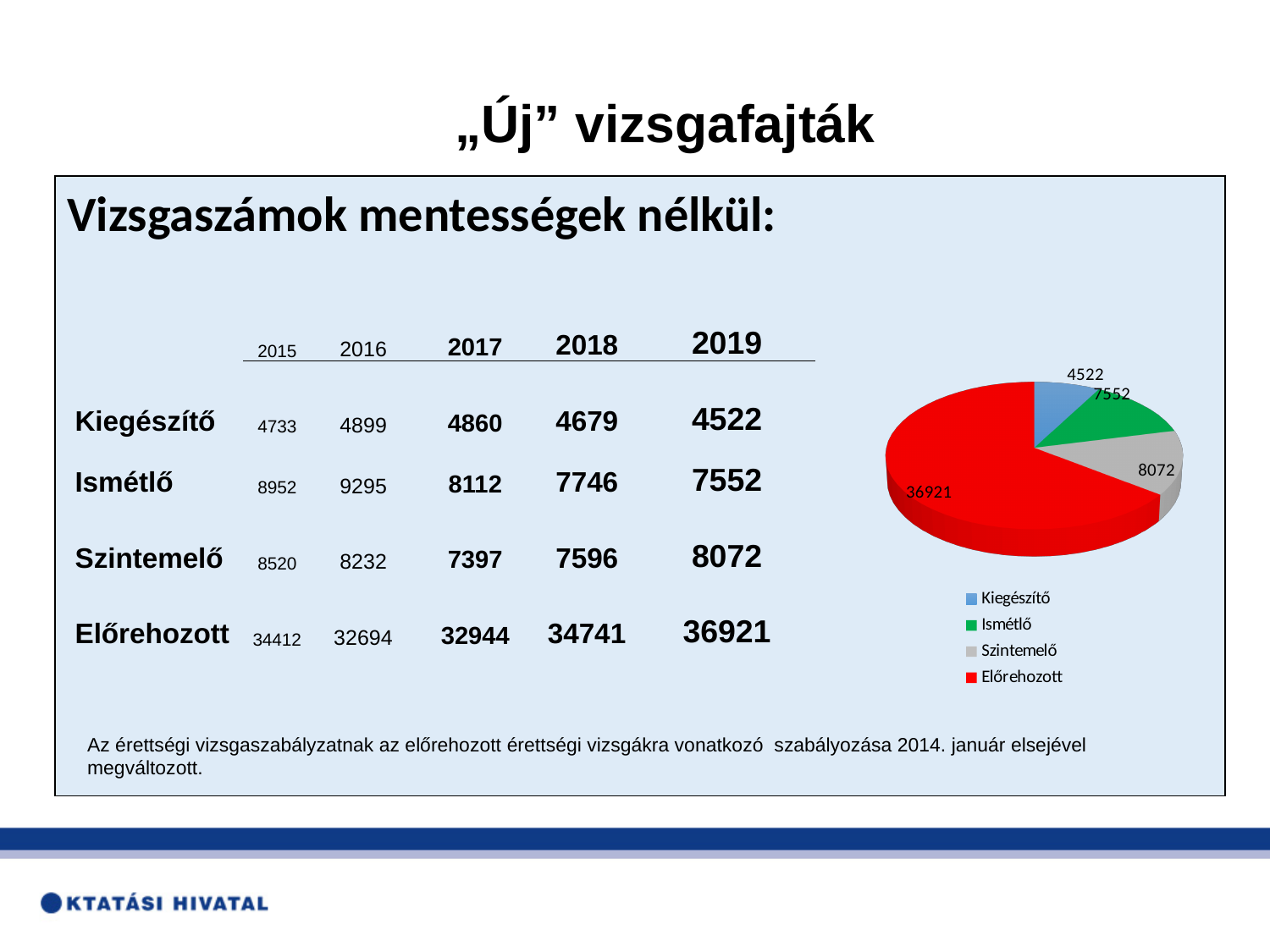
What is the total of all the values shown in the pie chart? 57067 How many entries does the pie chart legend list? 4 What is the value for Kiegészítő in the pie chart? 4522 What is the difference between the values for Szintemelő and Ismétlő in the pie chart? 520 How many slices does the pie chart have? 4 Which category has the largest slice in the pie chart? Előrehozott What colour is the Előrehozott slice in the pie chart? red What is the value for Szintemelő in the pie chart? 8072 What kind of chart is shown on the slide? pie chart Which is larger in the pie chart, Ismétlő or Szintemelő? Szintemelő What is the value for Előrehozott in the pie chart? 36921 Which category has the smallest slice in the pie chart? Kiegészítő